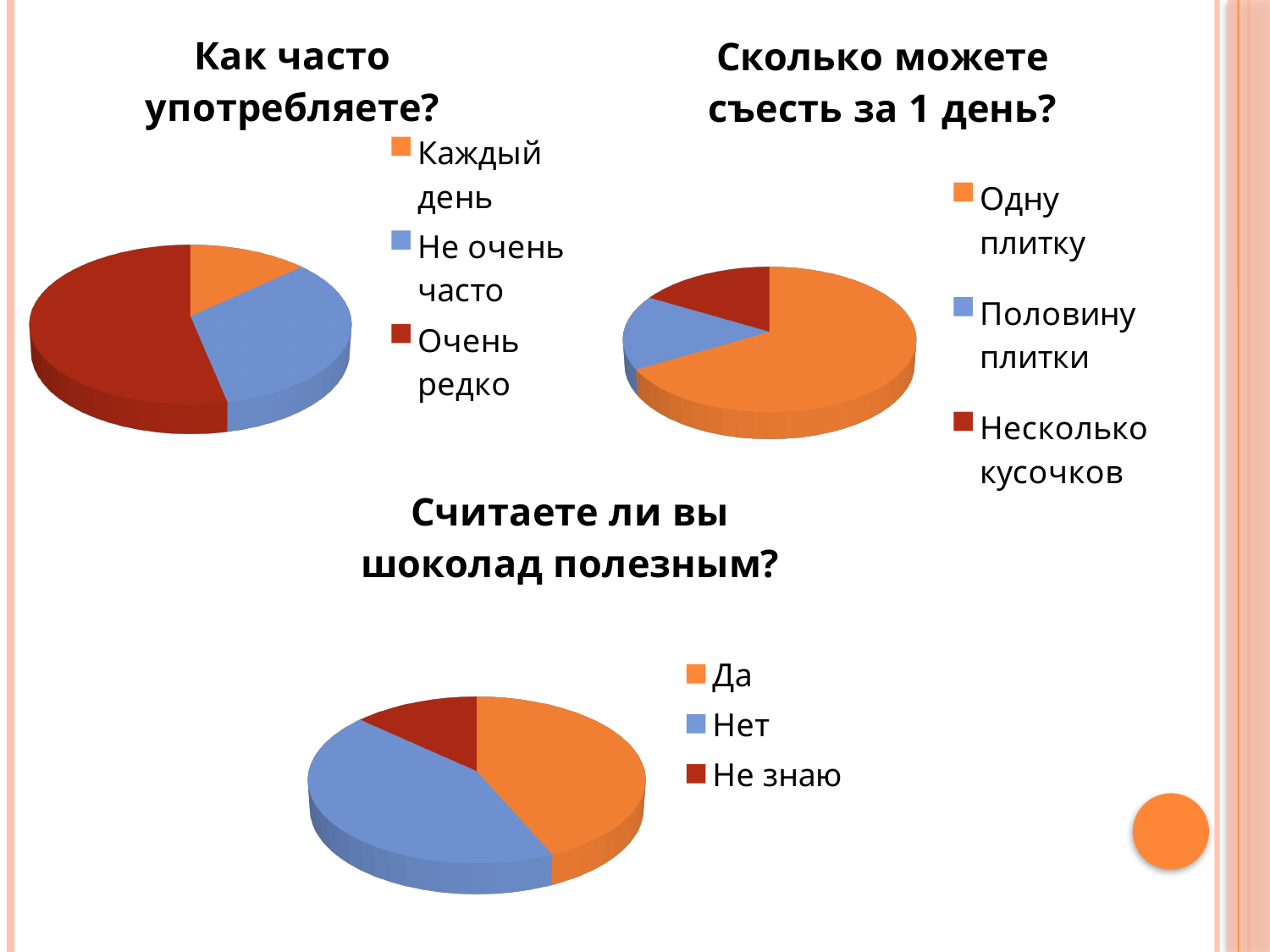
In the chart "Считаете ли вы шоколад полезным?", which slice is larger: "Нет" or "Не знаю"? Нет In the chart "Как часто употребляете?", how many categories does the legend list? 3 How many pie charts are on the slide? 3 In the chart "Как часто употребляете?", which category has the smallest slice? Каждый день In the chart "Считаете ли вы шоколад полезным?", what colour is the "Да" slice? orange In the chart "Как часто употребляете?", which slice is larger: "Не очень часто" or "Каждый день"? Не очень часто In the chart "Как часто употребляете?", which category has the largest slice? Очень редко In the chart "Сколько можете съесть за 1 день?", how many categories are shown? 3 In the chart "Сколько можете съесть за 1 день?", which slice is larger: "Одну плитку" or "Половину плитки"? Одну плитку What kind of chart is used for "Как часто употребляете?"? pie chart In the chart "Сколько можете съесть за 1 день?", which category has the largest slice? Одну плитку In the chart "Считаете ли вы шоколад полезным?", which category has the smallest slice? Не знаю